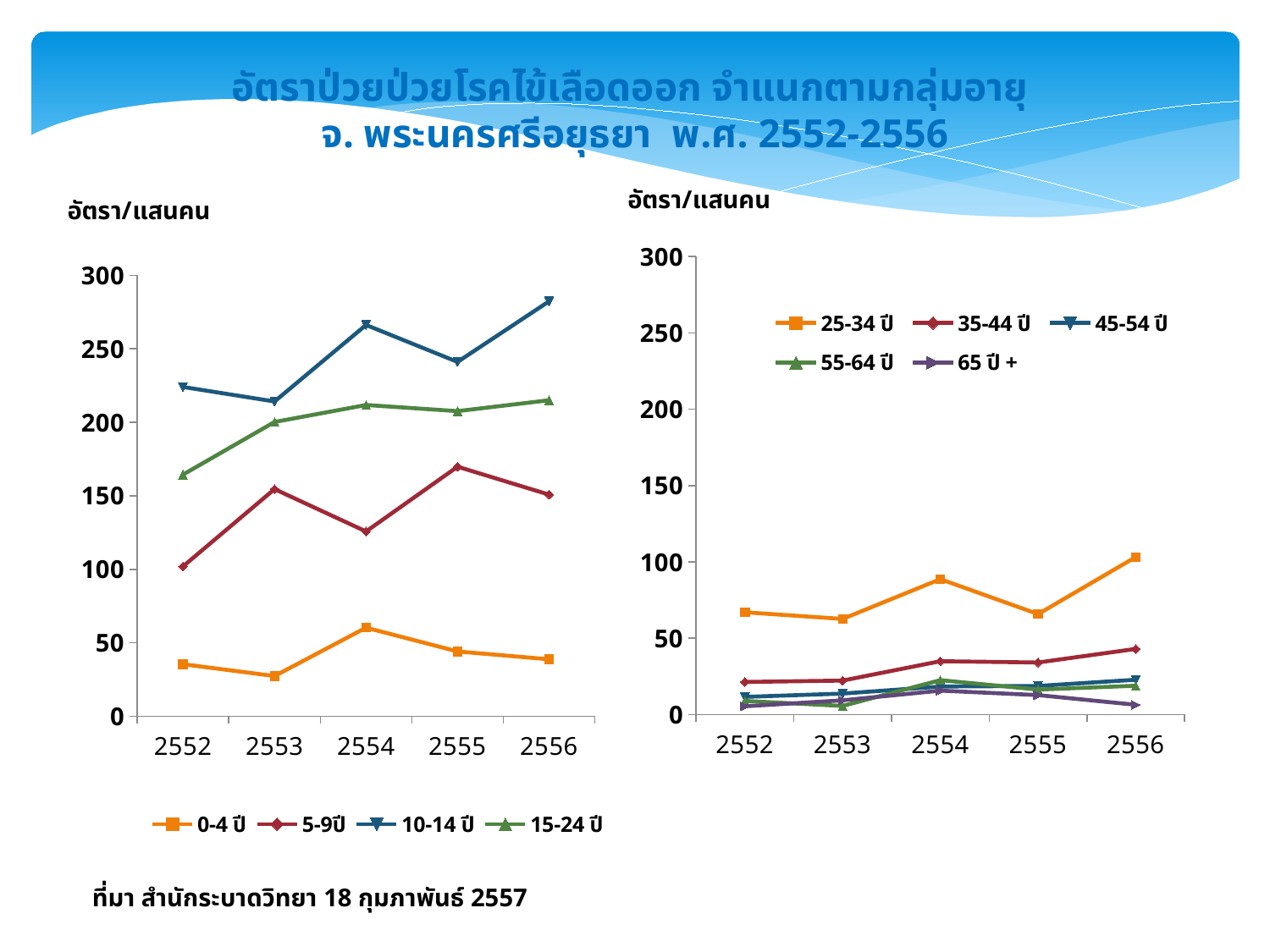
How many series does the legend of the left chart list? 4 In the left chart, is the value for 0-4 ปี in 2553 greater or less than 50? less How many series does the legend of the right chart list? 5 In the left chart, does the value for 10-14 ปี rise or fall from 2555 to 2556? rise In the left chart, which age group has the highest value in 2556? 10-14 ปี How many years are shown on the x axis of the left chart? 5 In the right chart, is the value for 25-34 ปี in 2554 greater or less than 100? less What kind of chart is the left chart on the slide? line chart In the left chart, which age group has the lowest value in 2553? 0-4 ปี In the right chart, which age group has the highest value in 2554? 25-34 ปี In the left chart, is the value for 10-14 ปี in 2554 greater or less than 250? greater In the right chart, which age group has the lowest value in 2556? 65 ปี +